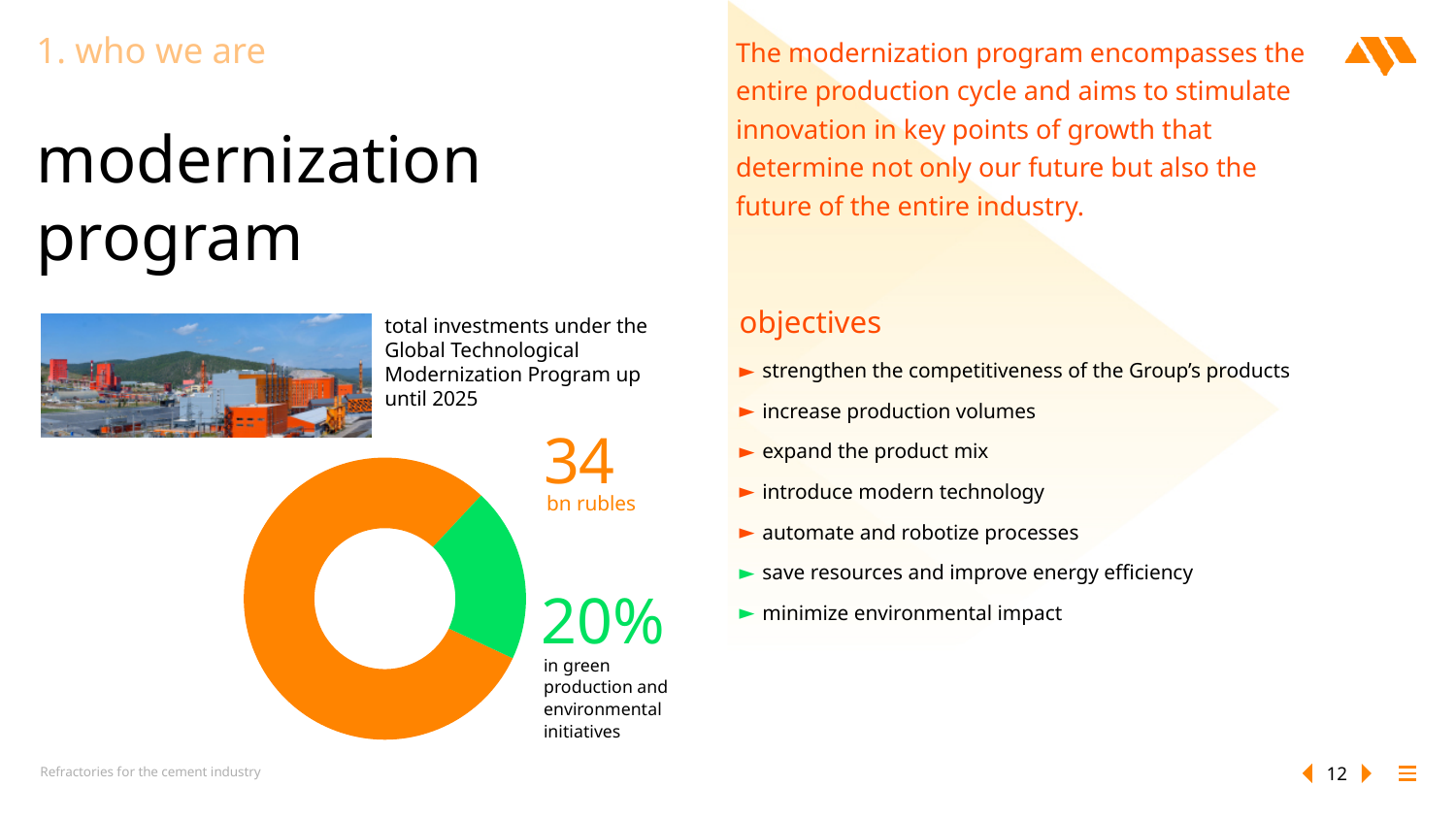
How many slices does the donut chart have? 2 What share of the donut chart is labelled as going to green production and environmental initiatives? 20% Which slice of the donut chart is larger, the orange one or the green one? The orange one What kind of chart is shown on the slide? Pie chart (donut) What colour is the slice representing green production and environmental initiatives? Green What total investment figure is shown next to the donut chart? 34 bn rubles What does the 20% slice of the donut chart represent? Investments in green production and environmental initiatives